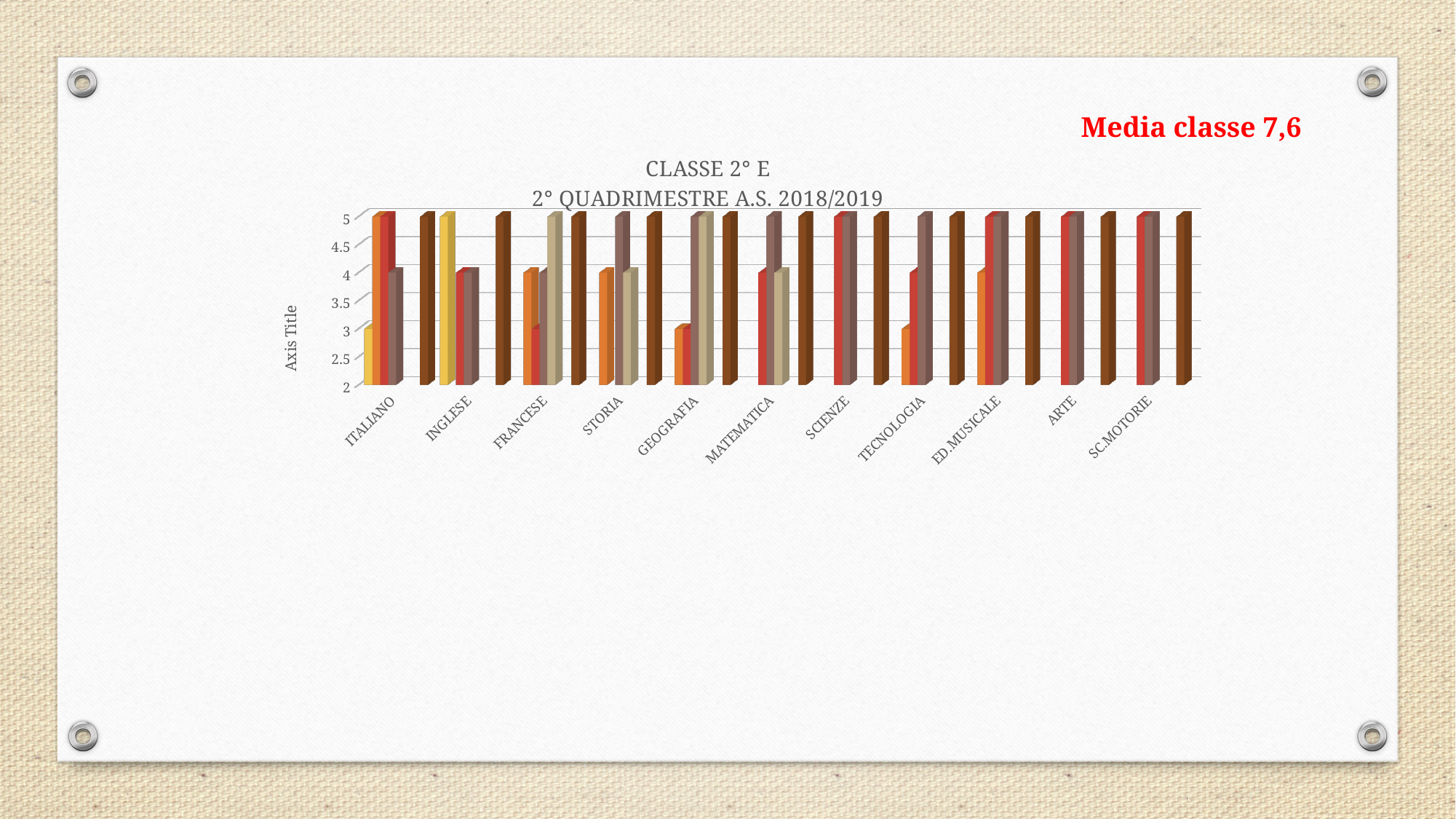
What is the lowest value shown on the vertical axis of the chart? 2 What is the title of the chart? CLASSE 2° E 2° QUADRIMESTRE A.S. 2018/2019 Is the shortest bar for TECNOLOGIA greater or less than 3.5? less Is the shortest bar for SCIENZE greater or less than 4.5? greater How many subject categories are shown along the x axis of the chart? 11 Is the shortest bar for GEOGRAFIA greater or less than 3.5? less What kind of chart is shown on the slide? bar chart What label is shown on the vertical axis of the chart? Axis Title What value does the tallest bar for ITALIANO reach on the vertical axis? 5 What value does the shortest bar for FRANCESE reach on the vertical axis? 3